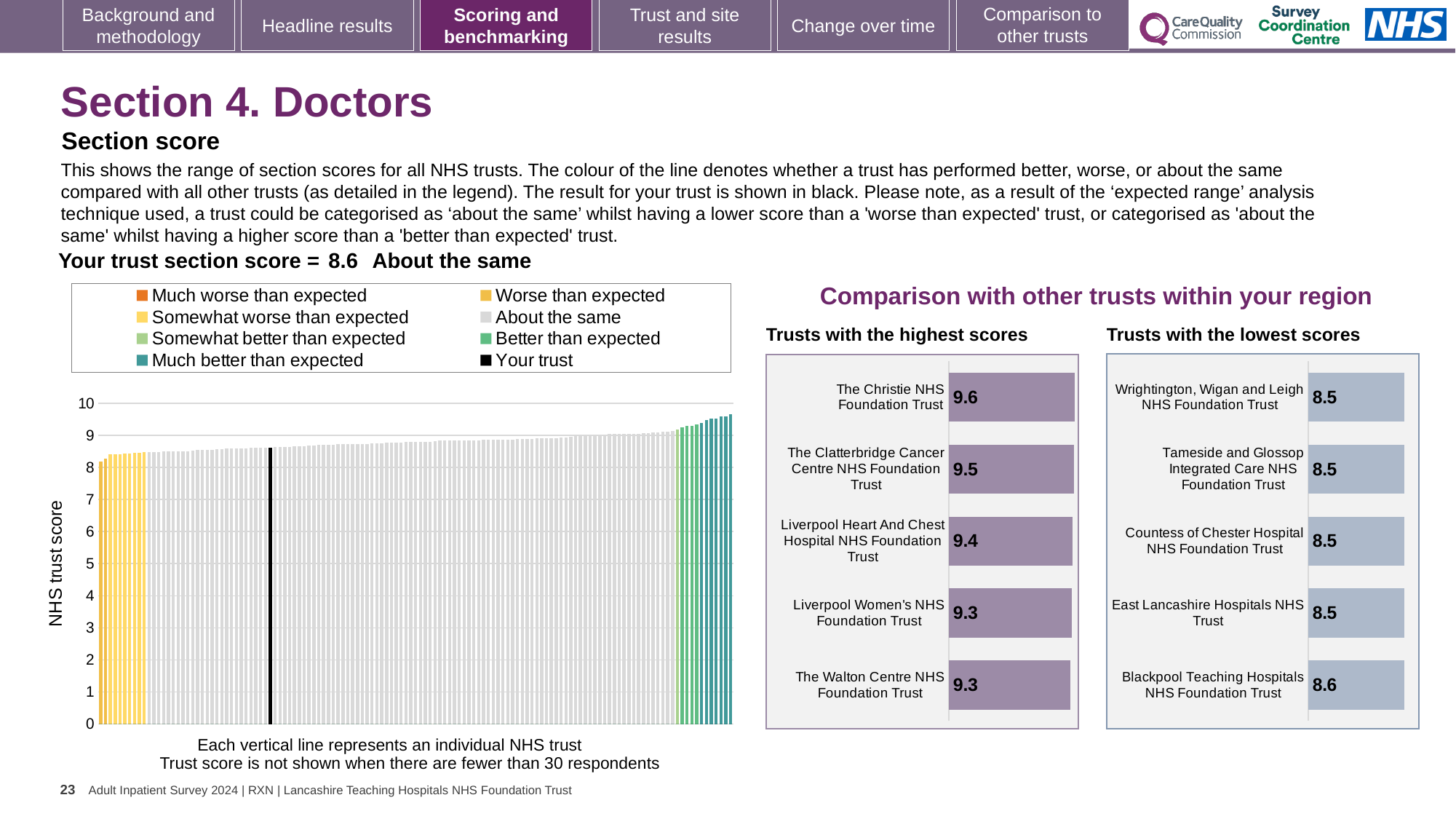
In the 'Trusts with the highest scores' chart, which has the larger score: The Clatterbridge Cancer Centre NHS Foundation Trust or Liverpool Heart And Chest Hospital NHS Foundation Trust? The Clatterbridge Cancer Centre NHS Foundation Trust In the 'Trusts with the highest scores' chart, which trust has the highest score? The Christie NHS Foundation Trust What type of chart is the large chart on the left showing NHS trust scores? Bar chart What is the section score for your trust shown on the slide? 8.6 In the large chart on the left, do the trust scores rise or fall from left to right along the x axis? Rise In the 'Trusts with the highest scores' chart, what is the score for The Christie NHS Foundation Trust? 9.6 In the large chart on the left, how many entries does the legend list? 8 In the 'Trusts with the highest scores' chart, how many trusts are shown? 5 In the 'Trusts with the highest scores' chart, what is the difference between the scores of The Christie NHS Foundation Trust and The Walton Centre NHS Foundation Trust? 0.3 In the 'Trusts with the lowest scores' chart, which trust has the highest score? Blackpool Teaching Hospitals NHS Foundation Trust In the 'Trusts with the lowest scores' chart, what is the score for Blackpool Teaching Hospitals NHS Foundation Trust? 8.6 What is the y-axis label of the large chart on the left? NHS trust score